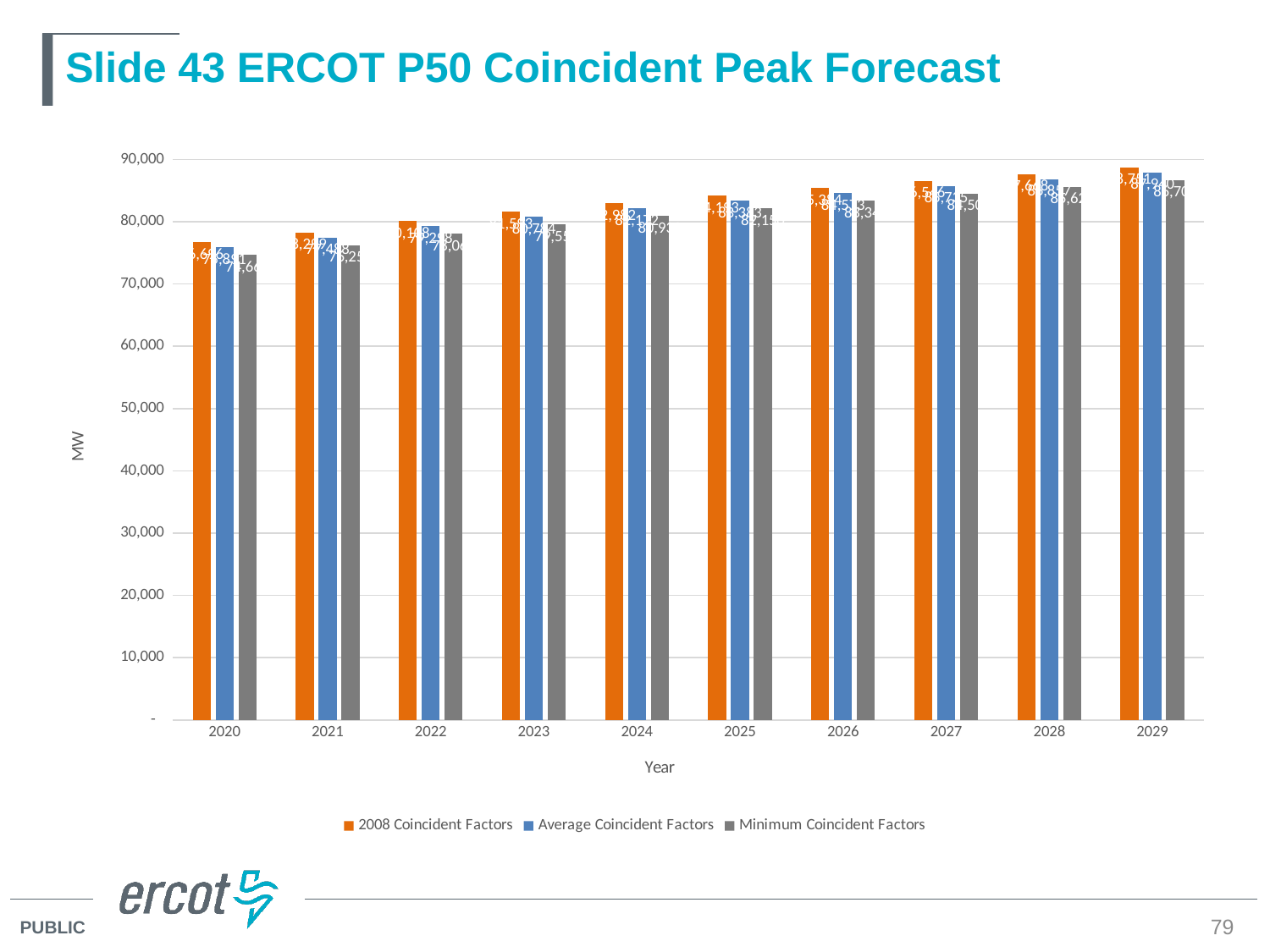
How many years are shown on the x axis of the chart? 10 Do the values for 2008 Coincident Factors rise or fall from 2020 to 2029? rise Which year has the lowest value for Minimum Coincident Factors? 2020 What is the label on the y axis of the chart? MW Is the value for Average Coincident Factors in 2029 greater or less than 80,000? greater Which year has the highest value for 2008 Coincident Factors? 2029 Is the value for Minimum Coincident Factors in 2020 greater or less than 80,000? less Which is larger for Average Coincident Factors: the value in 2020 or the value in 2029? 2029 How many series does the chart's legend list? 3 Is the value for 2008 Coincident Factors in 2029 greater or less than 90,000? less What kind of chart is shown on the slide? bar chart